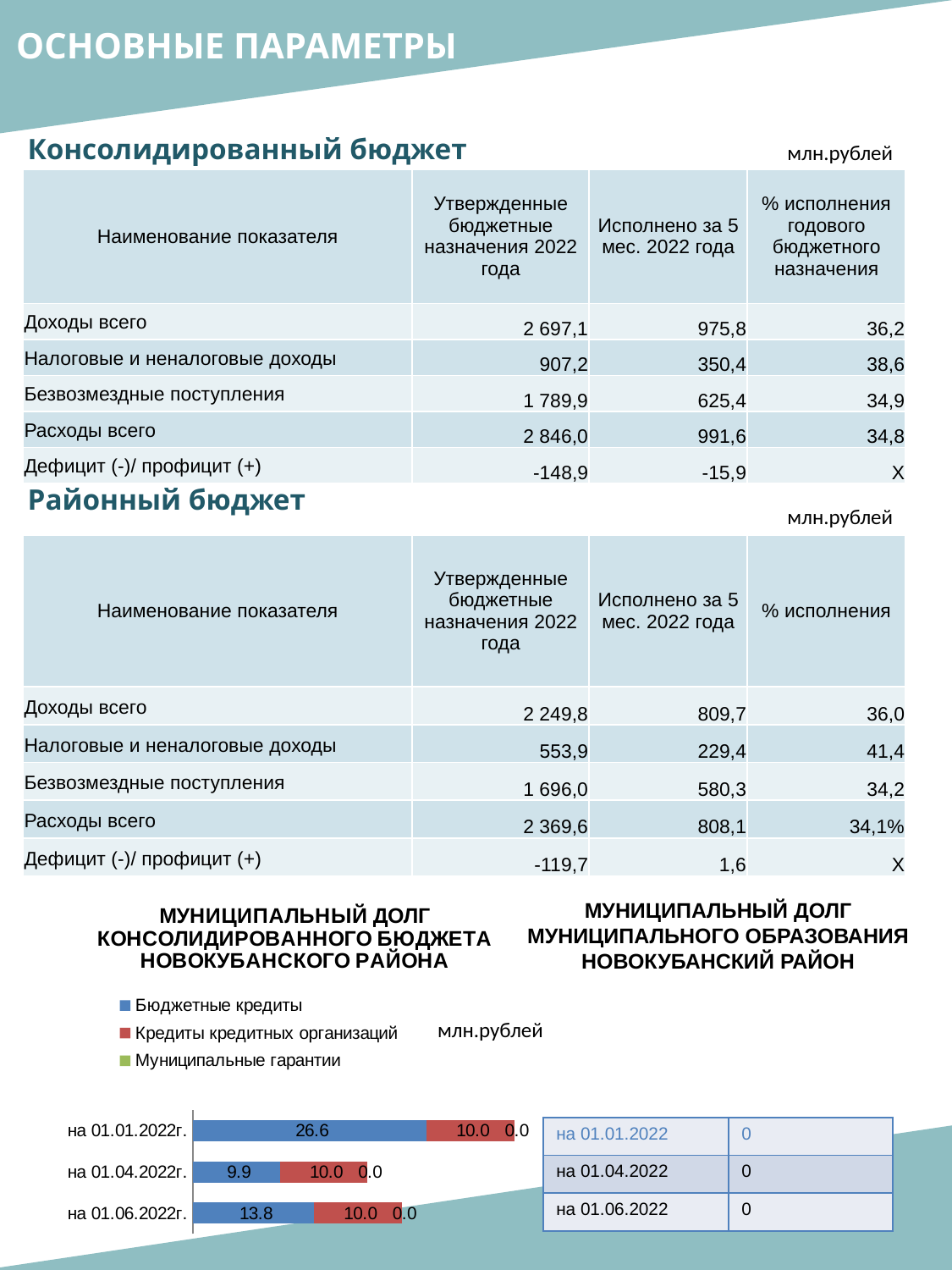
In the municipal debt chart, what is the difference between 'Бюджетные кредиты' on 01.01.2022 and on 01.04.2022? 16.7 In the municipal debt chart, what is the value of 'Бюджетные кредиты' on 01.01.2022? 26.6 How many dates (categories) are plotted in the municipal debt chart? 3 In the municipal debt chart, which is larger: 'Бюджетные кредиты' on 01.06.2022 or 'Кредиты кредитных организаций' on 01.06.2022? Бюджетные кредиты In the municipal debt chart, on which date is 'Бюджетные кредиты' lowest? на 01.04.2022г. In the municipal debt chart, what is the value of 'Муниципальные гарантии' on 01.04.2022? 0.0 What kind of chart is shown under the title 'МУНИЦИПАЛЬНЫЙ ДОЛГ КОНСОЛИДИРОВАННОГО БЮДЖЕТА НОВОКУБАНСКОГО РАЙОНА'? bar chart How many series does the legend of the municipal debt chart list? 3 In the municipal debt chart, on which date is 'Бюджетные кредиты' highest? на 01.01.2022г. In the municipal debt chart, what is the value of 'Бюджетные кредиты' on 01.04.2022? 9.9 In the municipal debt chart, what is the total of the stacked bar for 01.01.2022? 36.6 In the municipal debt chart, what is the value of 'Кредиты кредитных организаций' on 01.06.2022? 10.0